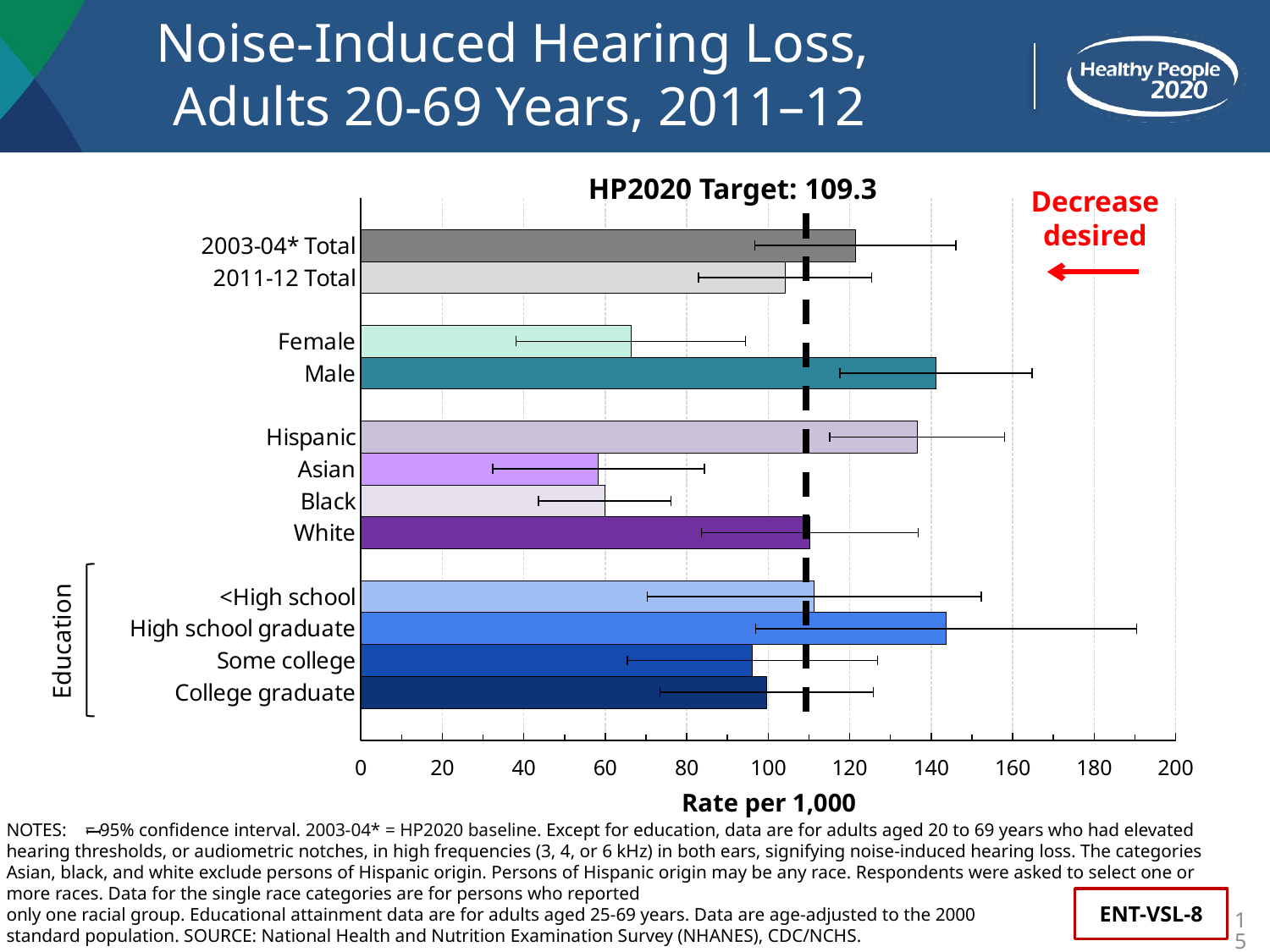
Which has the larger rate, Hispanic or Asian? Hispanic Is the value for Asian greater or less than 80? less Which has the larger rate, 2003-04* Total or 2011-12 Total? 2003-04* Total How many bars (categories) are plotted in the chart? 12 What is the HP2020 Target value shown above the chart? 109.3 Is the value for Female greater or less than 80? less Is the value for Male greater or less than 120? greater Which has the larger rate, High school graduate or Some college? High school graduate What is the label of the horizontal axis? Rate per 1,000 What kind of chart is shown on the slide? bar chart